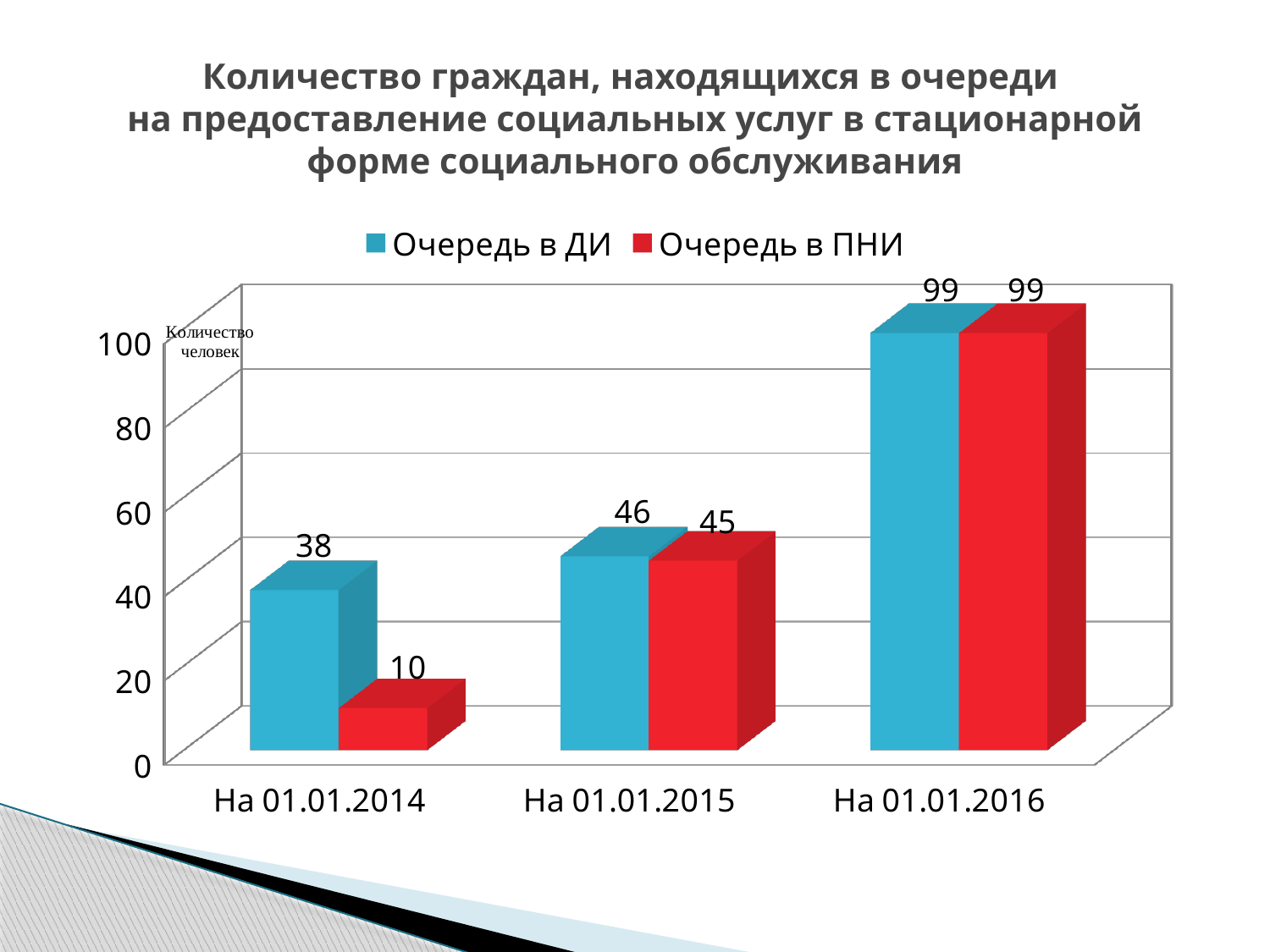
What is the value for Очередь в ДИ on На 01.01.2014? 38 What is the value for Очередь в ДИ on На 01.01.2016? 99 On which date is the value for Очередь в ДИ highest? На 01.01.2016 How many series does the legend list? 2 On which date is the value for Очередь в ПНИ lowest? На 01.01.2014 What is the difference between Очередь в ДИ and Очередь в ПНИ on На 01.01.2014? 28 Do the values for Очередь в ПНИ rise or fall from На 01.01.2014 to На 01.01.2016? rise What is the value for Очередь в ПНИ on На 01.01.2015? 45 What is the value for Очередь в ПНИ on На 01.01.2014? 10 How many dates are shown on the x axis? 3 Which is larger on На 01.01.2015: Очередь в ДИ or Очередь в ПНИ? Очередь в ДИ By how much did Очередь в ДИ increase from На 01.01.2015 to На 01.01.2016? 53